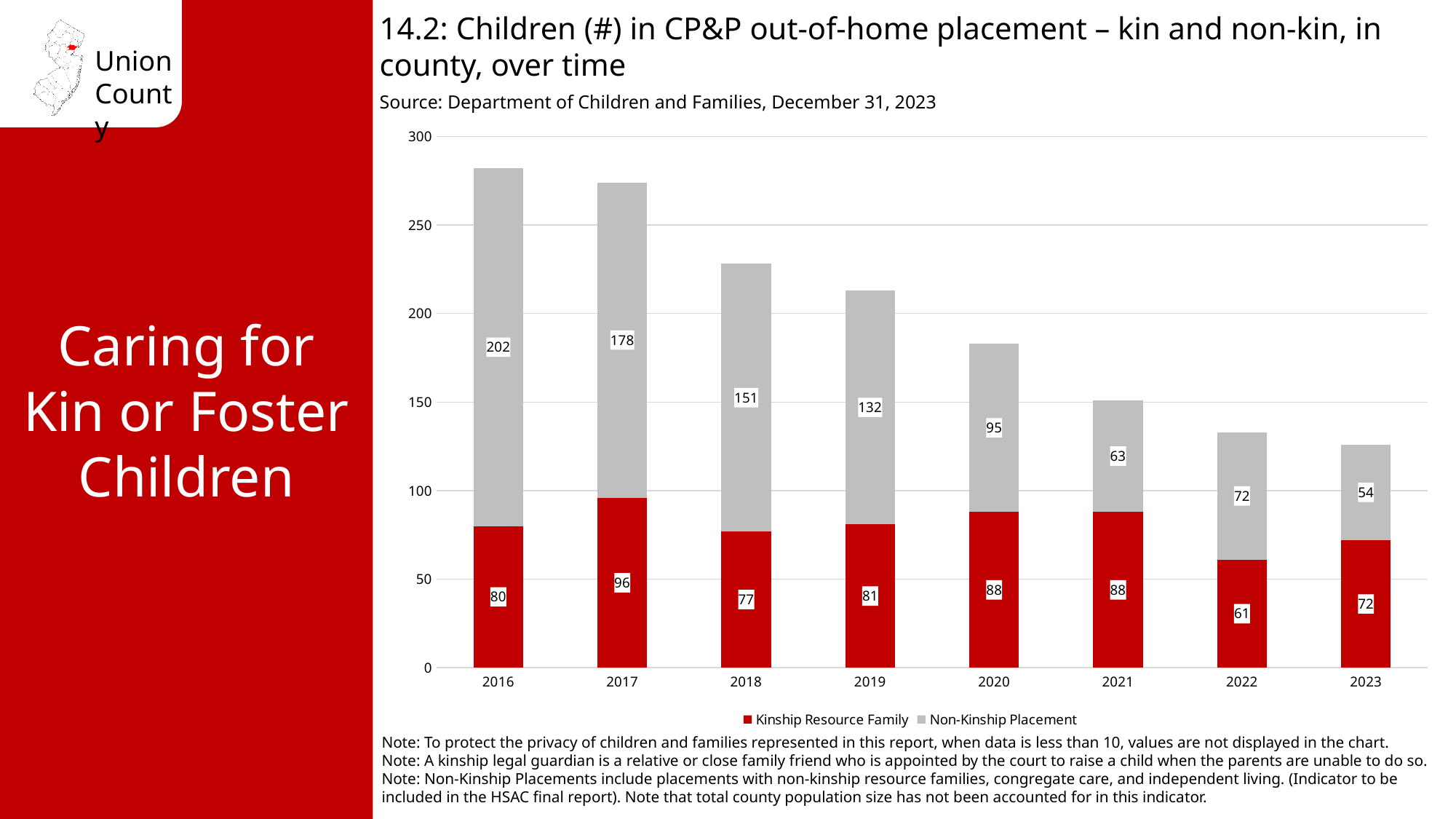
What is the Kinship Resource Family value for 2017? 96 Which year has the highest Non-Kinship Placement value? 2016 What is the total number of children in out-of-home placement in 2020 (both segments combined)? 183 Do the Non-Kinship Placement values generally rise or fall from 2016 to 2021? Fall What is the difference between the Non-Kinship Placement values for 2016 and 2023? 148 What kind of chart is shown on the slide? Stacked bar chart Which year has the lowest Kinship Resource Family value? 2022 Which is larger in 2022: the Kinship Resource Family value or the Non-Kinship Placement value? Non-Kinship Placement What is the total of the stacked bar for 2016? 282 How many years are shown on the x axis? 8 How many series does the legend list? 2 What is the Non-Kinship Placement value for 2019? 132